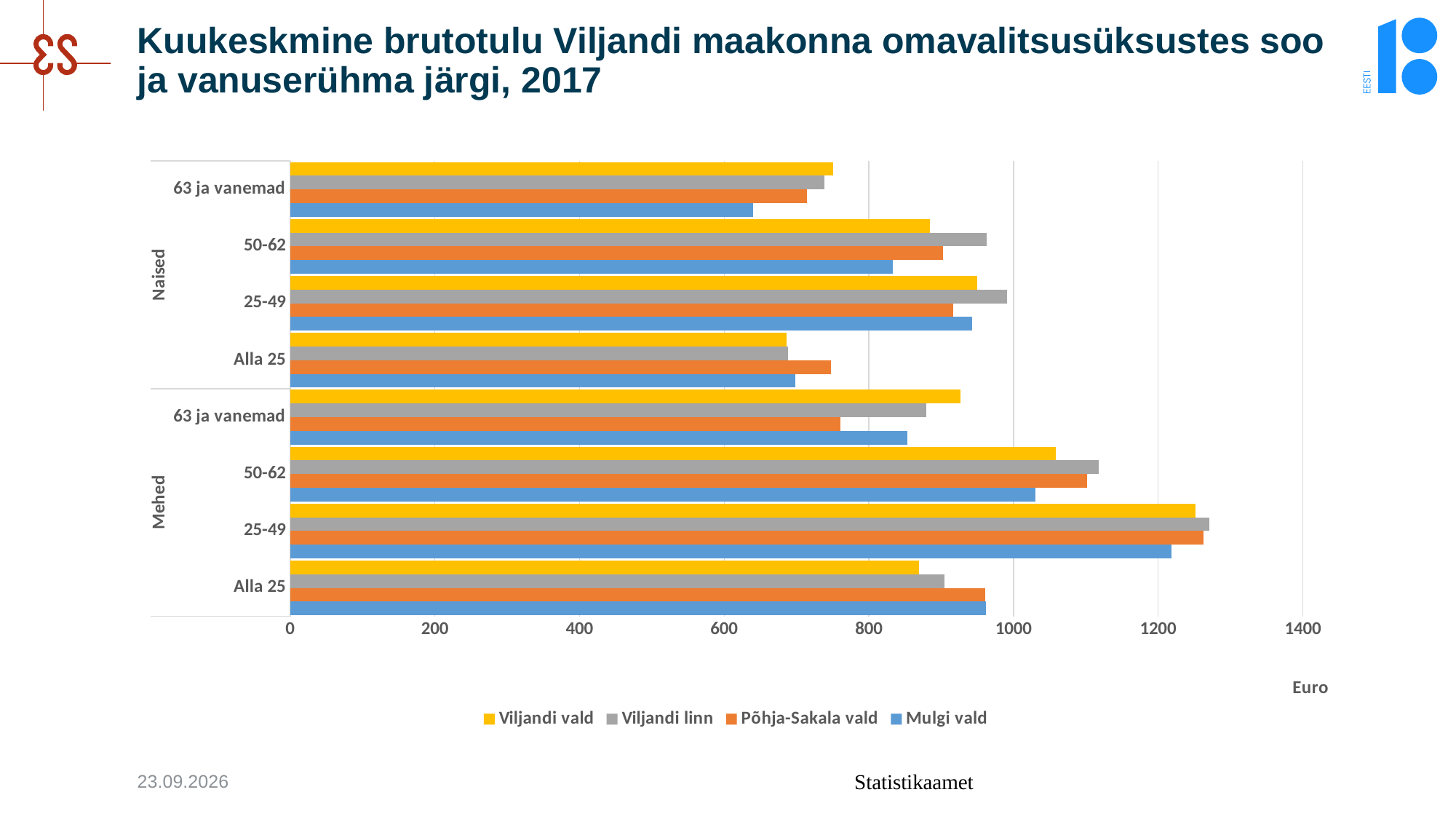
For Viljandi vald among Mehed, which is larger: the 25-49 group or the Alla 25 group? 25-49 What unit is shown on the horizontal axis? Euro How many series does the legend list? 4 In the Naised 63 ja vanemad group, which series has the lowest value? Mulgi vald Is the value for Viljandi linn in the Mehed 25-49 group greater or less than 1200? greater Is the value for Mulgi vald in the Naised 63 ja vanemad group greater or less than 800? less How many age-group categories are plotted in total across both genders? 8 Is the value for Viljandi vald in the Mehed 50-62 group greater or less than 1000? greater What kind of chart is shown on the slide? bar chart Which series are listed in the legend? Viljandi vald, Viljandi linn, Põhja-Sakala vald, Mulgi vald